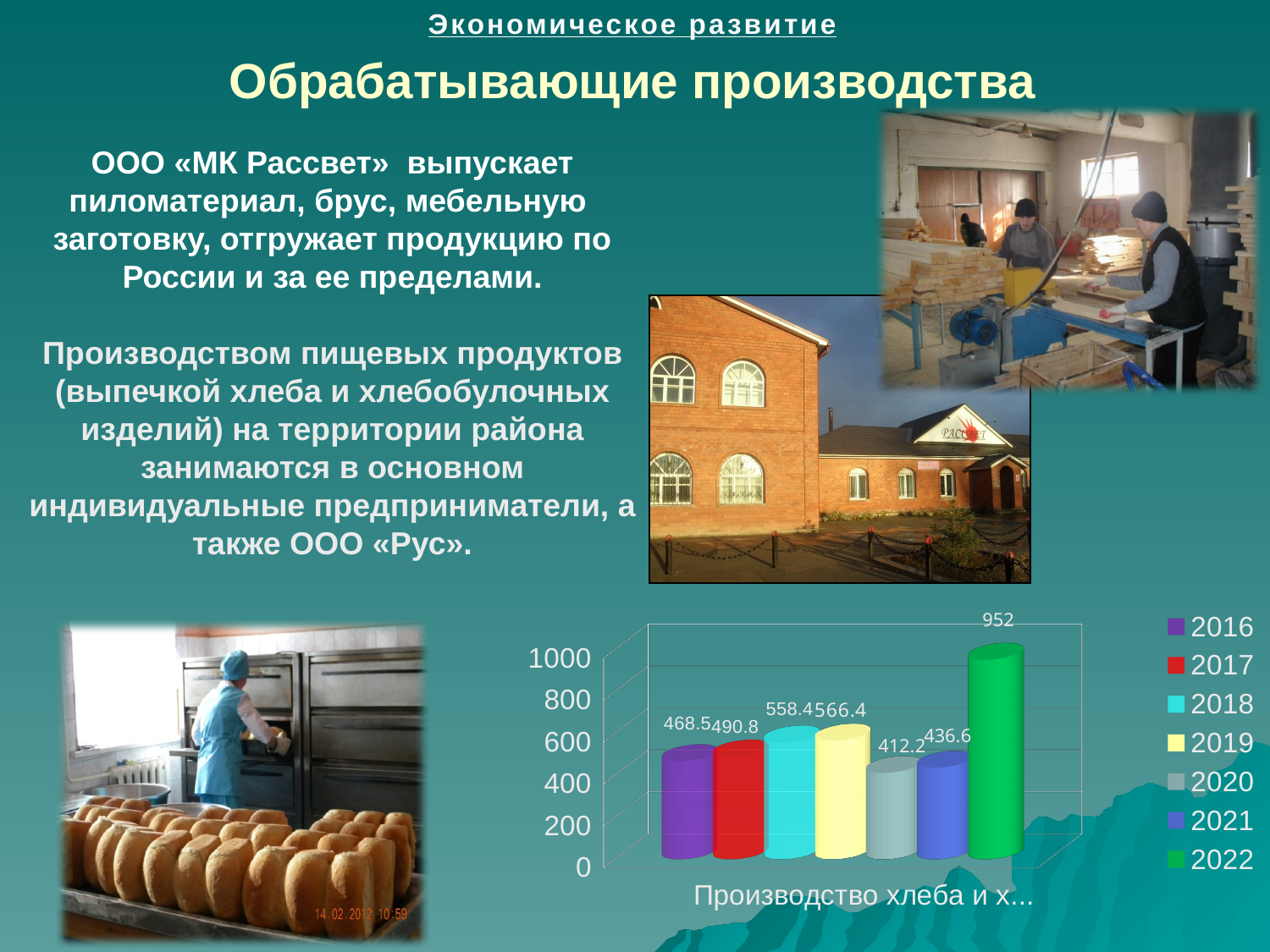
Which is larger, the value for 2017 or the value for 2021? 2017 What is the difference between the values for 2018 and 2017? 67.6 What is the difference between the values for 2022 and 2021? 515.4 What colour is the bar for 2022 in the chart? Green Which year has the lowest value in the chart? 2020 What is the value for 2022 in the chart? 952 Which year has the highest value in the chart? 2022 What is the value for 2016 in the chart? 468.5 What is the value for 2019 in the chart? 566.4 How many series does the legend list? 7 What is the value for 2020 in the chart? 412.2 What kind of chart is shown on the slide? Bar chart